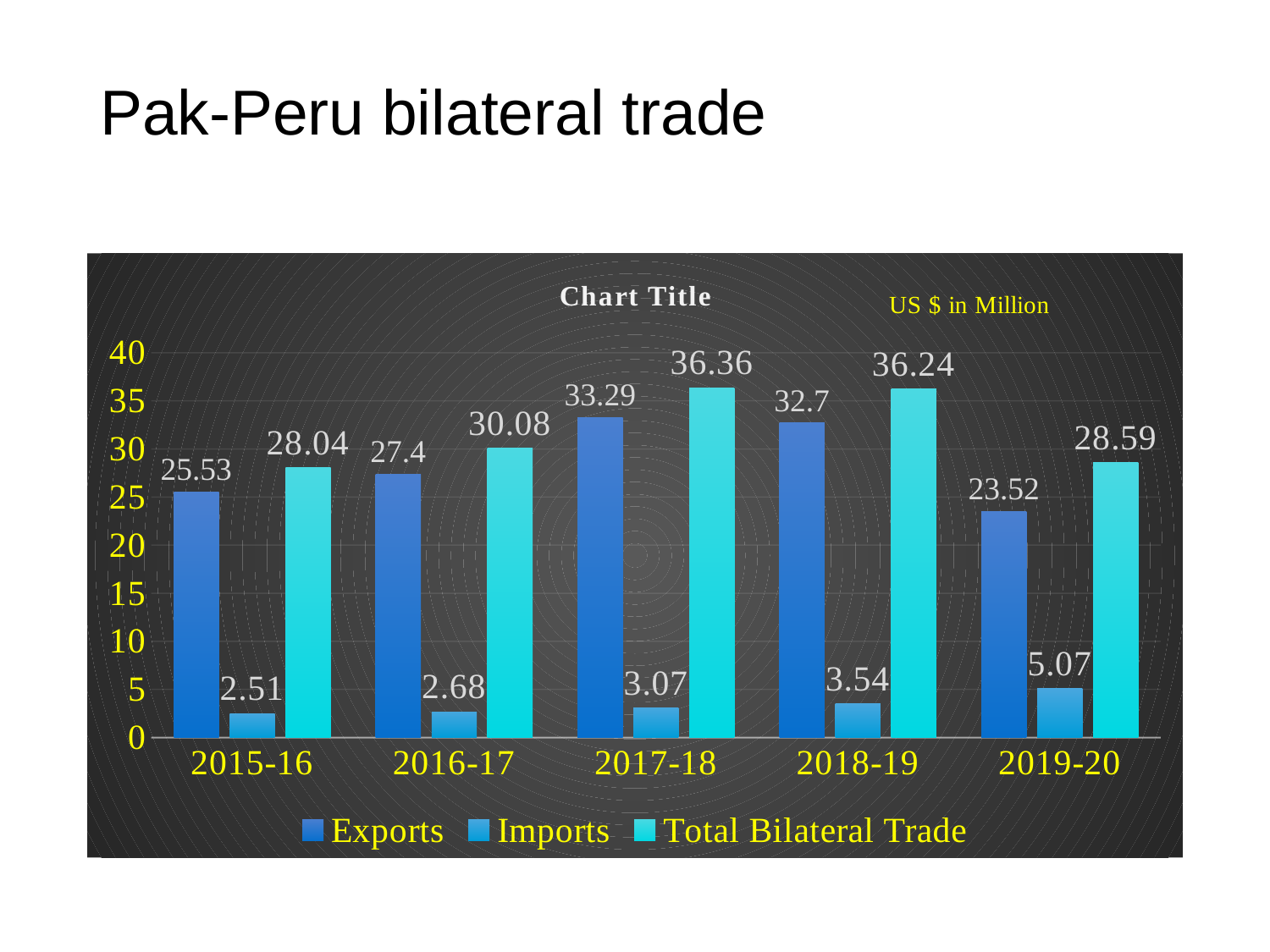
Which year has the highest Total Bilateral Trade? 2017-18 How many series does the legend list? 3 Do the Imports values rise or fall from 2015-16 to 2019-20? Rise What kind of chart is shown on the slide? Bar chart Which year has the lowest Exports value? 2019-20 What is the difference between Exports and Imports in 2018-19? 29.16 Which is larger, Exports in 2015-16 or Exports in 2016-17? Exports in 2016-17 What is the value of Exports for 2017-18? 33.29 What unit is stated for the values in the chart? US $ in Million What is the value of Imports for 2019-20? 5.07 How many years are shown on the x axis? 5 What is the value of Total Bilateral Trade for 2016-17? 30.08